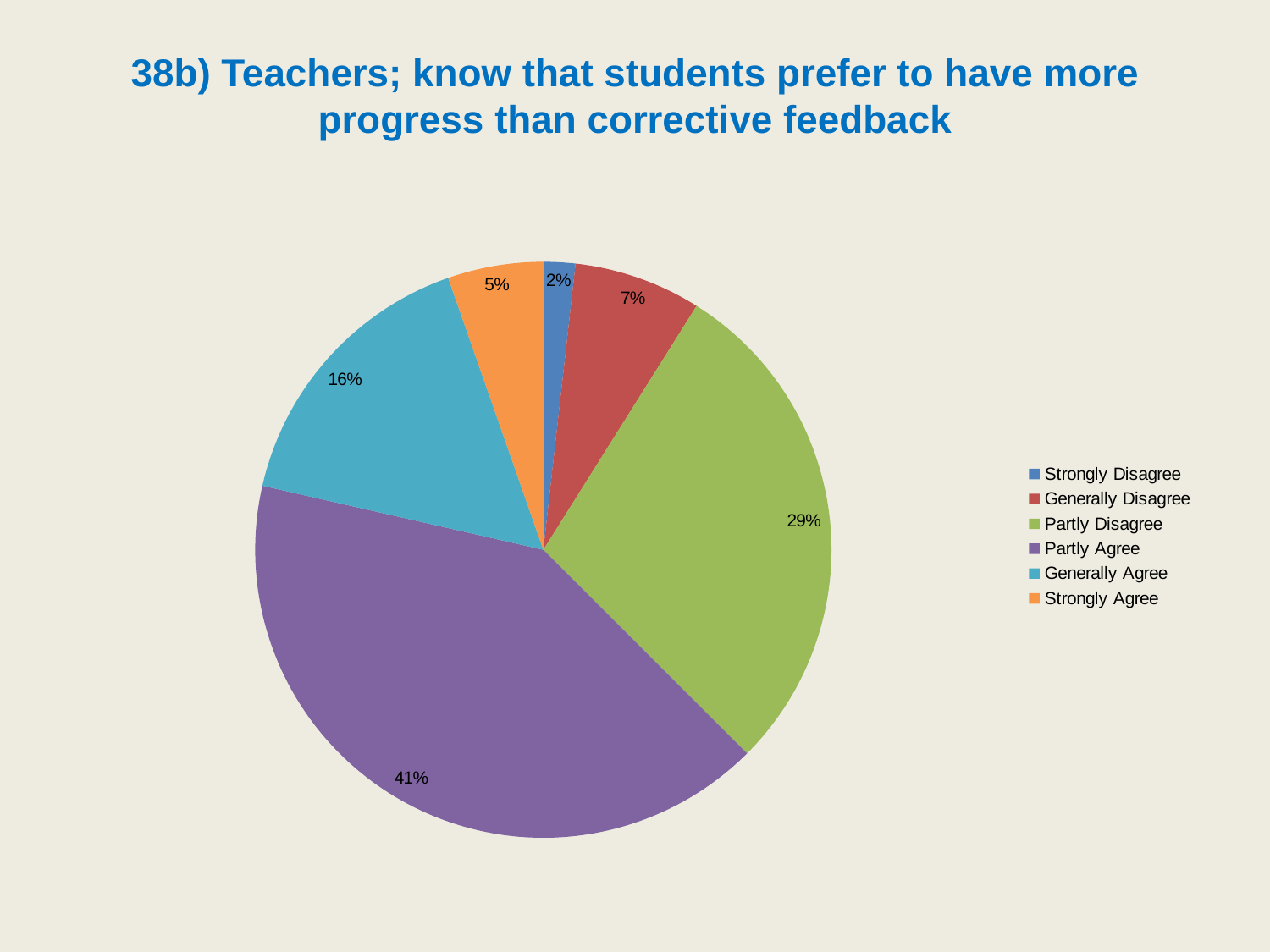
Which category has the smallest slice of the pie? Strongly Disagree How many categories does the legend list? 6 What share of the pie is Strongly Disagree? 2% Which is larger, Generally Disagree or Generally Agree? Generally Agree What is the difference in percentage points between Partly Agree and Partly Disagree? 12 What share of the pie is Partly Agree? 41% What colour is the Partly Agree slice? purple What share of the pie is Generally Agree? 16% Which category has the largest slice of the pie? Partly Agree What kind of chart is shown on the slide? pie chart